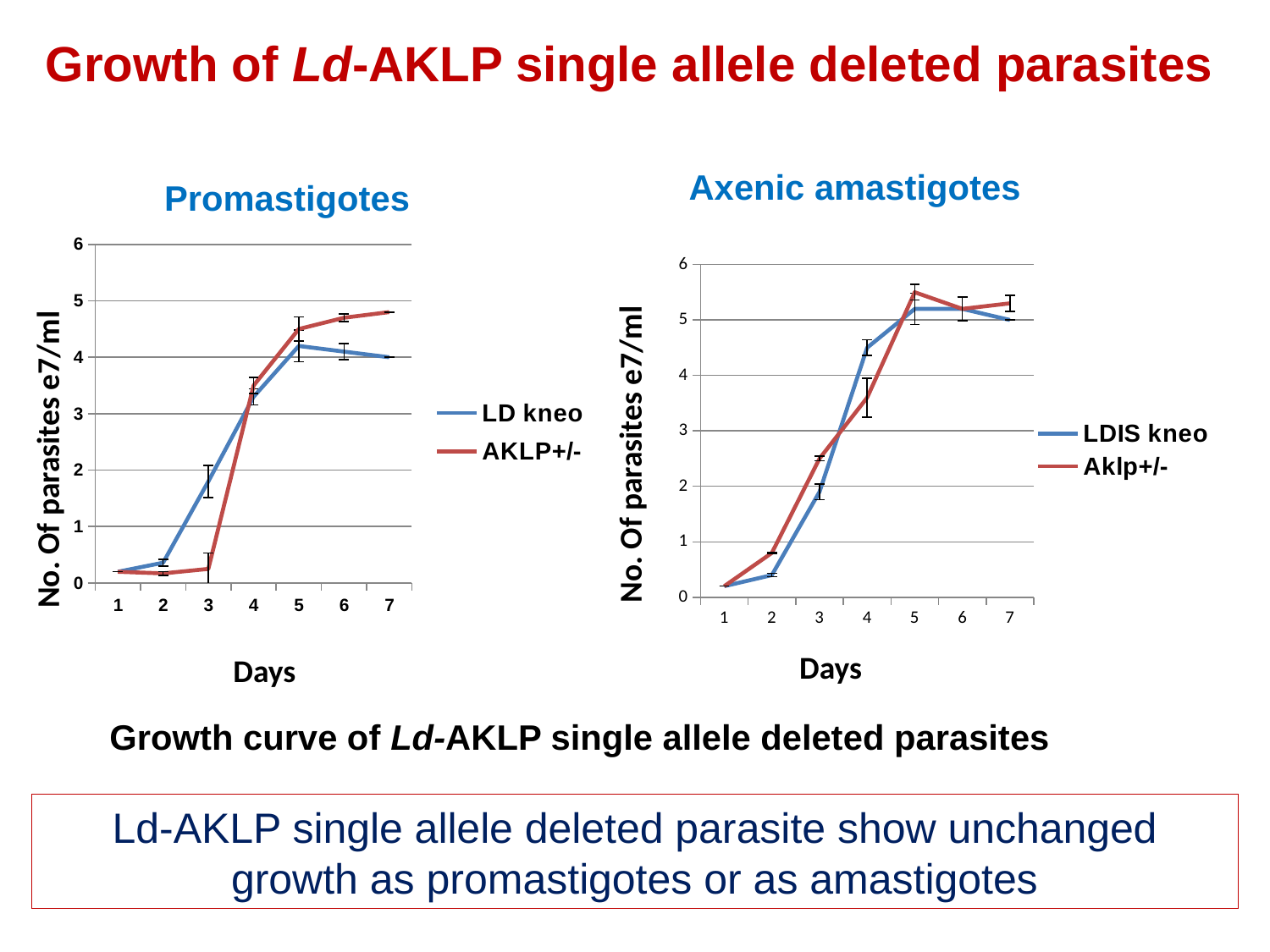
In the Axenic amastigotes chart, is the value for Aklp+/- on day 2 greater or less than 1? less In the Promastigotes chart, which series has the higher value on day 7, LD kneo or AKLP+/-? AKLP+/- In the Axenic amastigotes chart, is the value for LDIS kneo on day 4 greater or less than 4? greater What is the y-axis label of the Promastigotes chart? No. Of parasites e7/ml How many series does the legend of the Promastigotes chart list? 2 In the Promastigotes chart, is the value for AKLP+/- on day 3 greater or less than 1? less In the Axenic amastigotes chart, does the LDIS kneo series generally rise or fall from day 1 to day 5? rise How many series does the legend of the Axenic amastigotes chart list? 2 How many days are plotted along the x axis of the Axenic amastigotes chart? 7 In the Promastigotes chart, which series has the higher value on day 3, LD kneo or AKLP+/-? LD kneo What kind of chart is the Promastigotes chart? line chart